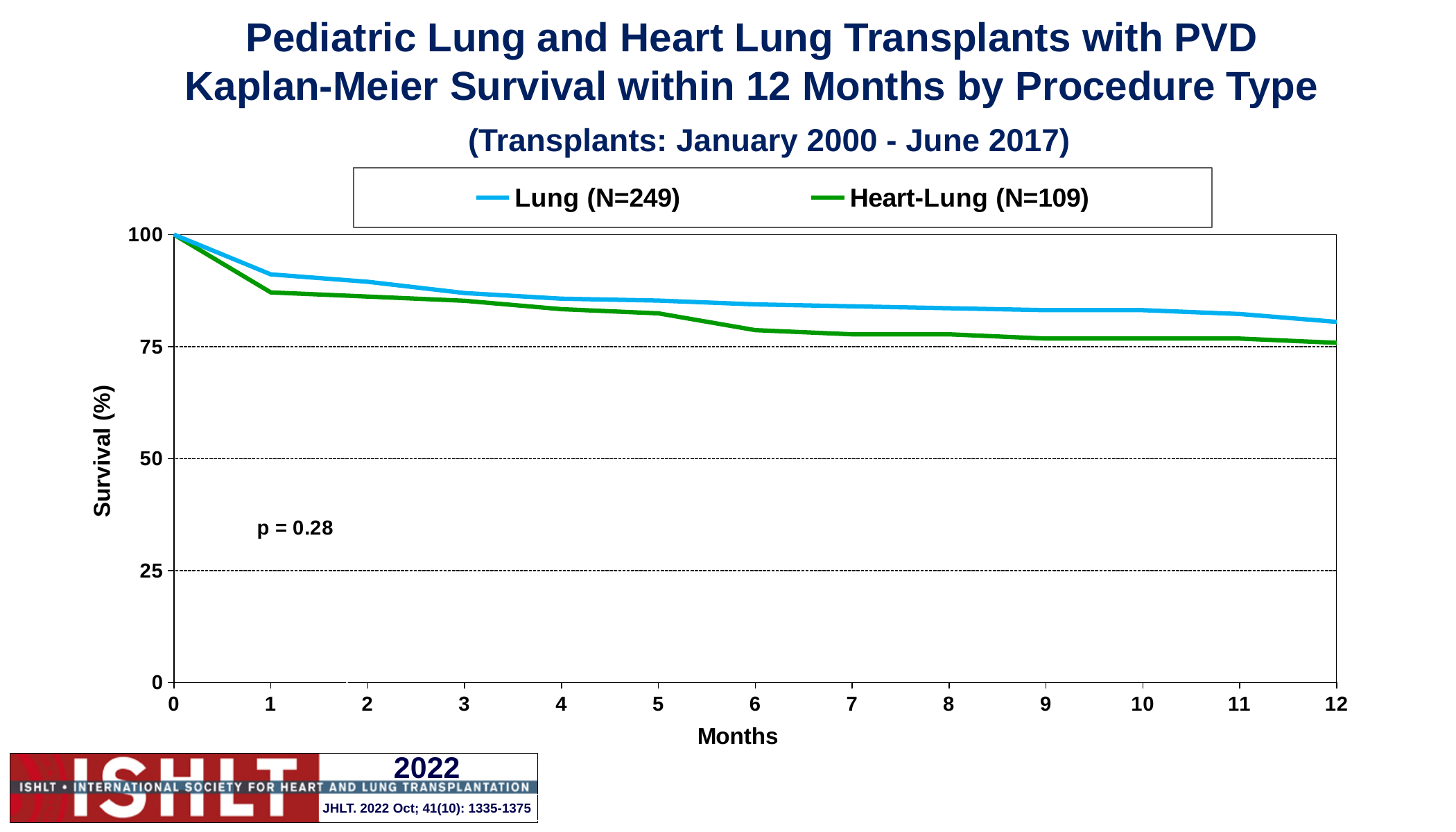
What is the maximum value shown on the x axis (Months)? 12 Is the survival value for the Heart-Lung series at 6 months greater or less than 75? greater How many series does the legend list? 2 Is the survival value for the Lung series at 12 months greater or less than 75? greater What is the sample size (N) for the Heart-Lung series? 109 Which series has the lower survival at 12 months? Heart-Lung At 6 months, which series has the higher survival, Lung or Heart-Lung? Lung What kind of chart is shown on the slide? Line chart What is the survival value for the Lung series at month 0? 100 Do the survival values for the Heart-Lung series rise or fall as months increase? Fall What p-value is printed on the chart? p = 0.28 What are the two series named in the legend? Lung (N=249) and Heart-Lung (N=109)